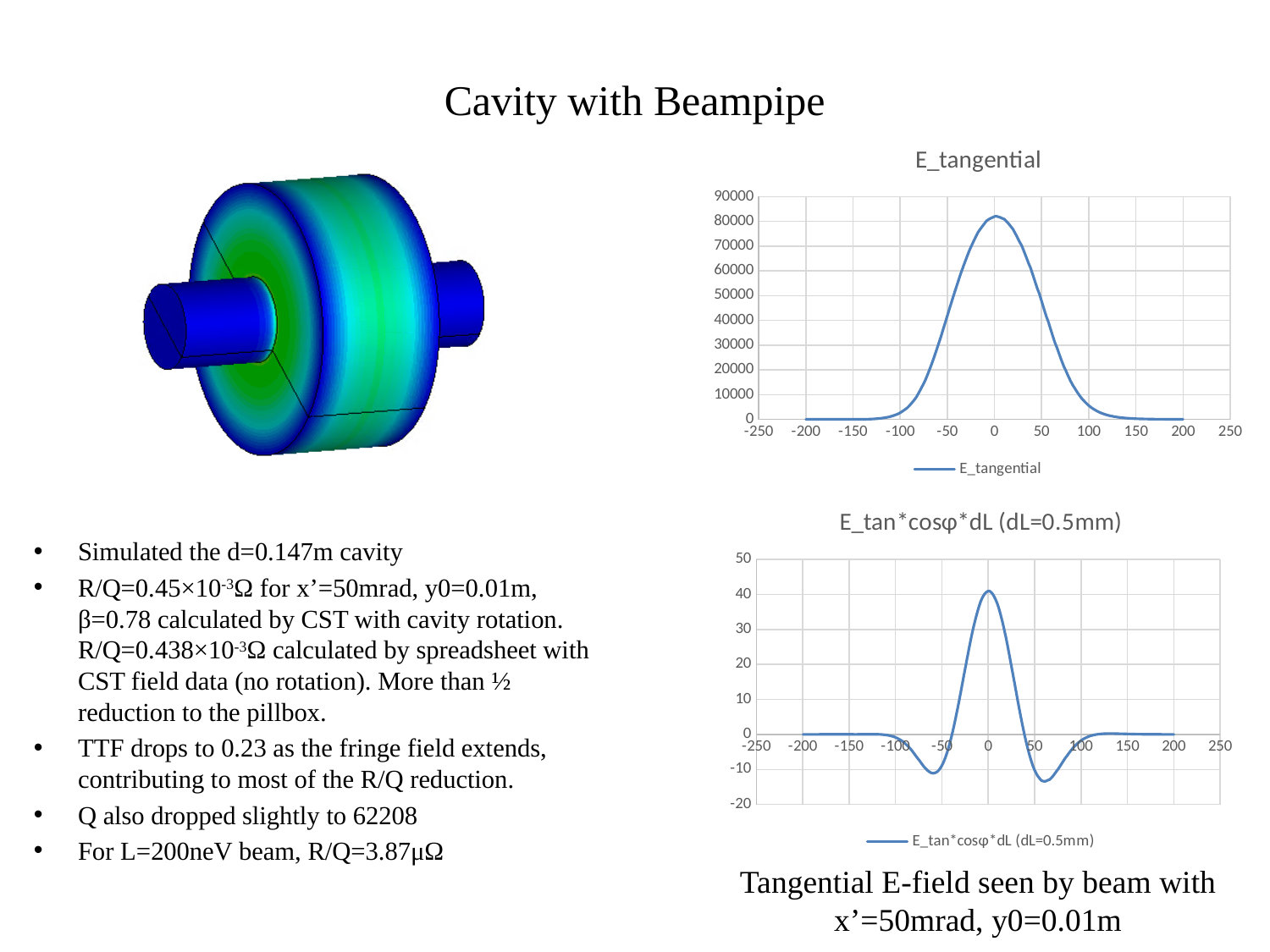
In the E_tan*cosφ*dL (dL=0.5mm) chart, does the curve rise or fall as x goes from 0 to 50? fall In the E_tangential chart, is the value at x = 0 greater or less than 70000? greater In the E_tangential chart, does the curve rise or fall as x goes from -100 to 0? rise How many series does the legend of the E_tangential chart list? 1 In the E_tangential chart, is the value at x = -200 greater or less than 10000? less What is the title of the lower chart on the slide? E_tan*cosφ*dL (dL=0.5mm) In the E_tan*cosφ*dL (dL=0.5mm) chart, is the value at x = 0 greater or less than 30? greater What is the legend entry shown below the E_tangential chart? E_tangential What kind of chart is the E_tangential chart? line chart What kind of chart is the E_tan*cosφ*dL (dL=0.5mm) chart? line chart